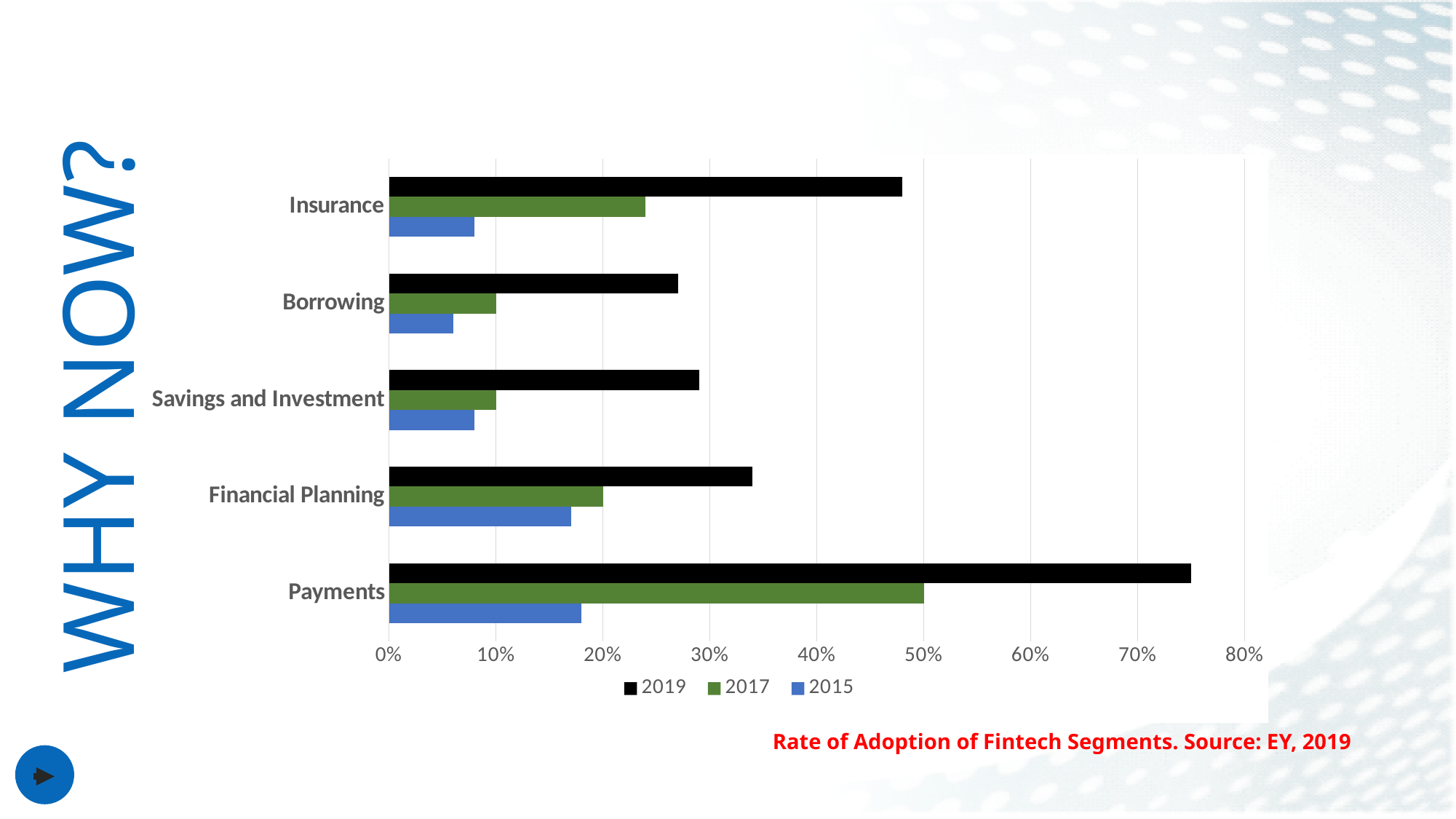
How many series does the legend list? 3 How many fintech segments (categories) are shown on the chart? 5 What caption is given below the chart describing the data and its source? Rate of Adoption of Fintech Segments. Source: EY, 2019 Is the 2019 value for Payments greater or less than 70%? greater Which segment has the lowest adoption rate for 2015? Borrowing Which is larger: the 2015 value for Financial Planning or the 2015 value for Savings and Investment? Financial Planning Which is larger: the 2017 value for Insurance or the 2017 value for Borrowing? Insurance Which segment has the highest adoption rate for 2019? Payments Is the 2019 value for Financial Planning greater or less than 30%? greater What kind of chart is shown on the slide? bar chart Is the 2015 value for Borrowing greater or less than 10%? less